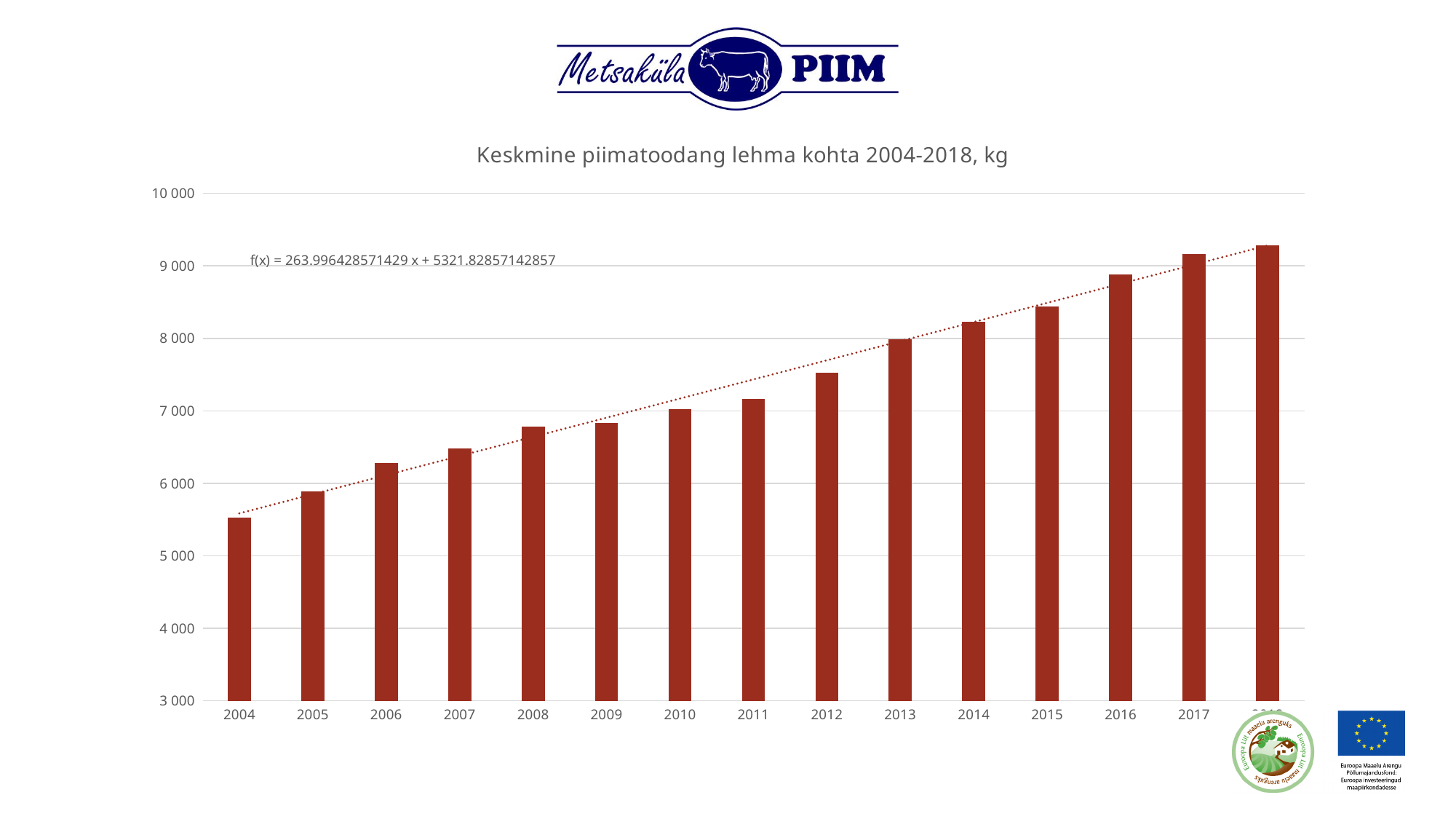
Is the value for 2012 greater or less than 7 000? greater Is the value for 2008 greater or less than 7 000? less Is the value for 2004 greater or less than 6 000? less What kind of chart is shown on the slide? bar chart Do the values generally rise or fall from 2004 to 2018? rise Which year has the lowest average milk yield per cow? 2004 Which year has the larger value, 2009 or 2015? 2015 How many bars (years) are plotted in the chart? 15 What is the title of the chart? Keskmine piimatoodang lehma kohta 2004-2018, kg What trendline equation is printed on the chart? f(x) = 263.996428571429 x + 5321.82857142857